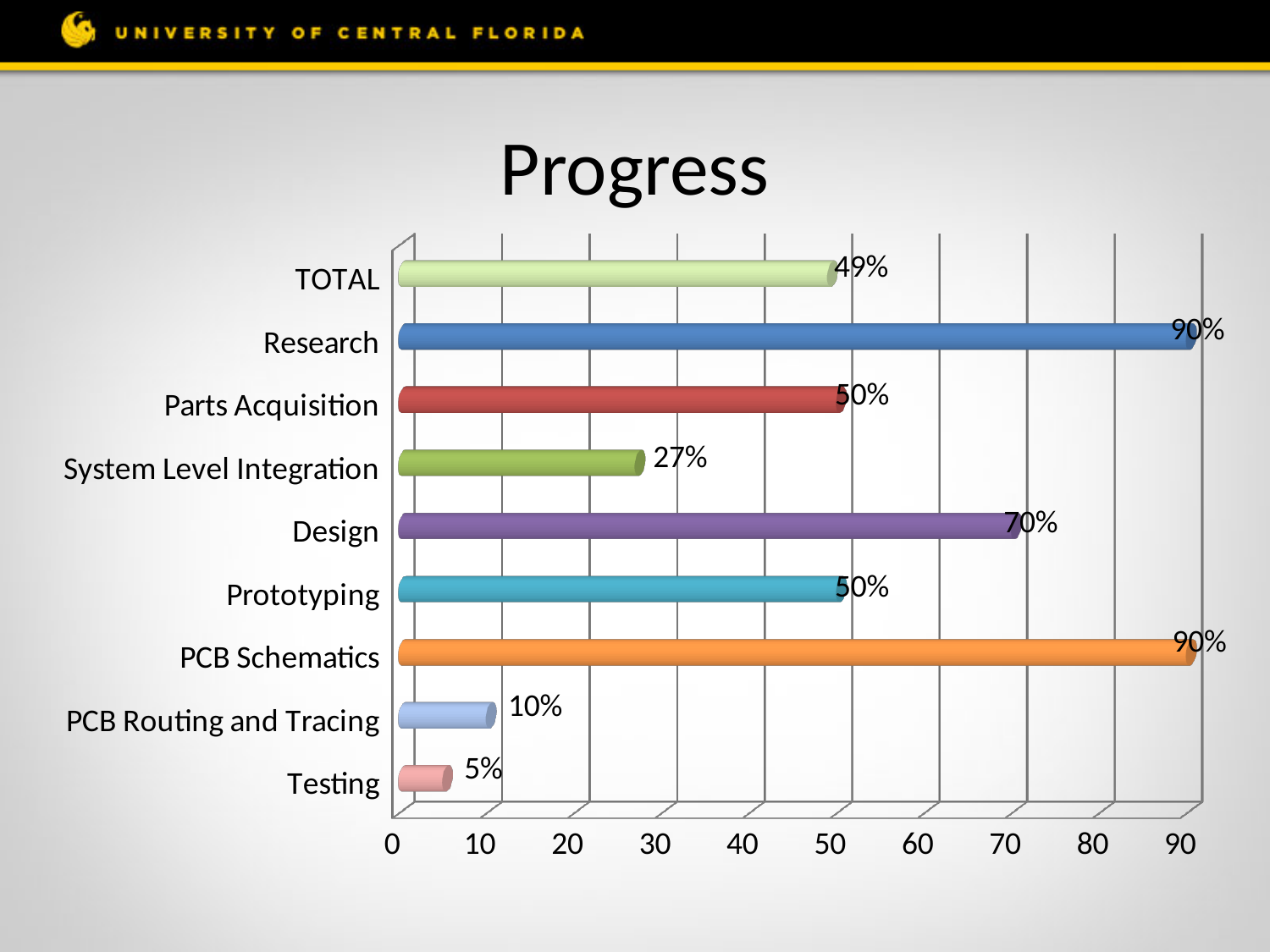
Which category has the lowest value? Testing What is the value for Design? 70% What is the value for System Level Integration? 27% Which is larger, the value for Parts Acquisition or the value for System Level Integration? Parts Acquisition Is the value for Design greater or less than 60? greater What is the difference between the values for Research and Testing? 85% What is the title of the chart? Progress What is the value for TOTAL? 49% What is the difference between the values for Design and Prototyping? 20% How many categories are shown in the chart? 9 What kind of chart is shown on the slide? bar chart What is the value for PCB Routing and Tracing? 10%